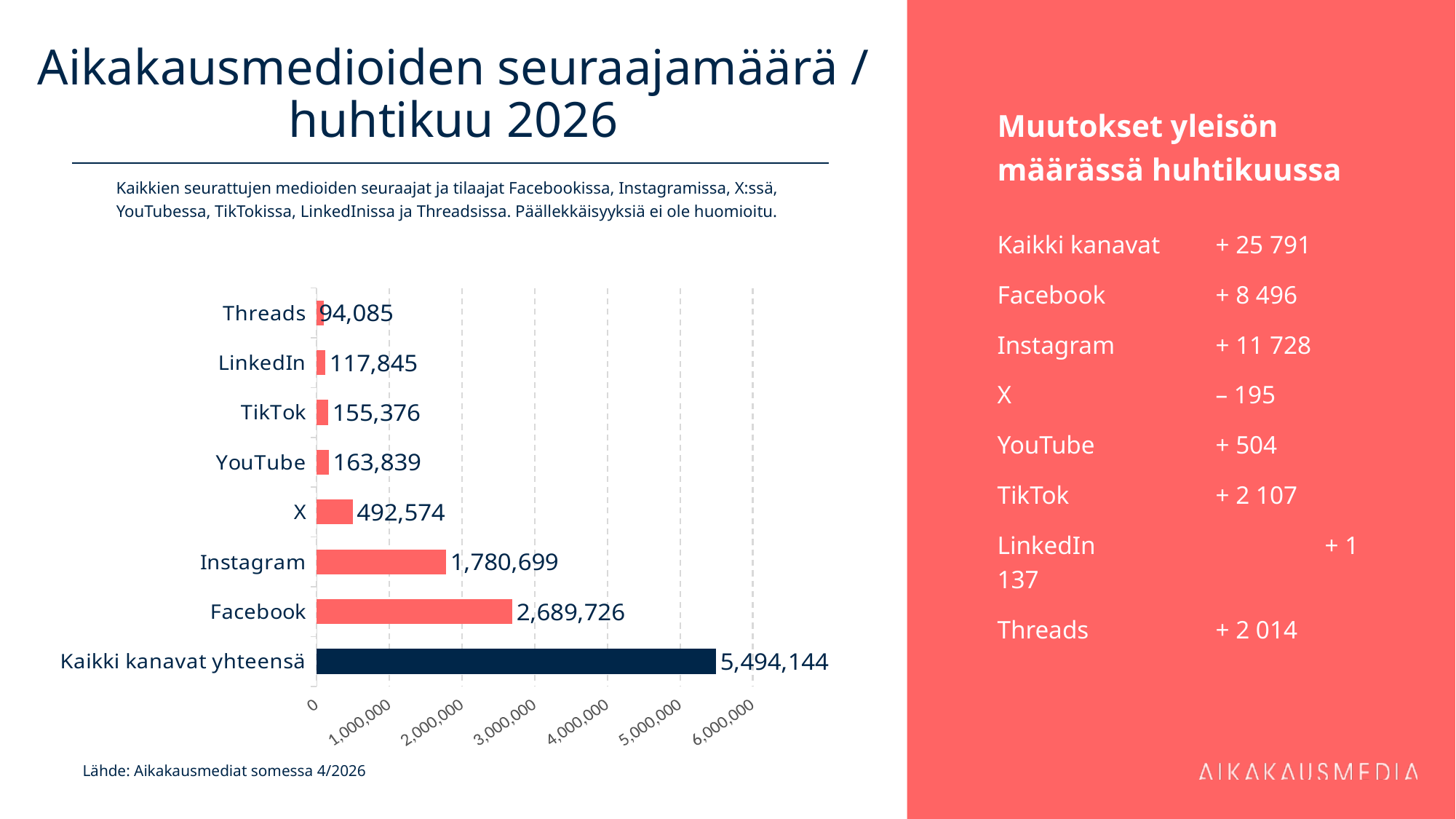
What type of chart is shown on the slide? Bar chart What is the difference between the Facebook and Instagram values? 909,027 Which individual channel (excluding the total bar) has the highest follower count? Facebook Which is larger, the value for X or the value for YouTube? X What is the difference between the YouTube and TikTok values? 8,463 What is the value shown for Instagram? 1,780,699 What is the follower count shown for Facebook? 2,689,726 How many categories (bars) are shown in the chart? 8 What is the title of the slide's chart? Aikakausmedioiden seuraajamäärä / huhtikuu 2026 What is the value shown for Threads? 94,085 What is the value shown for 'Kaikki kanavat yhteensä'? 5,494,144 Which category has the lowest value in the chart? Threads